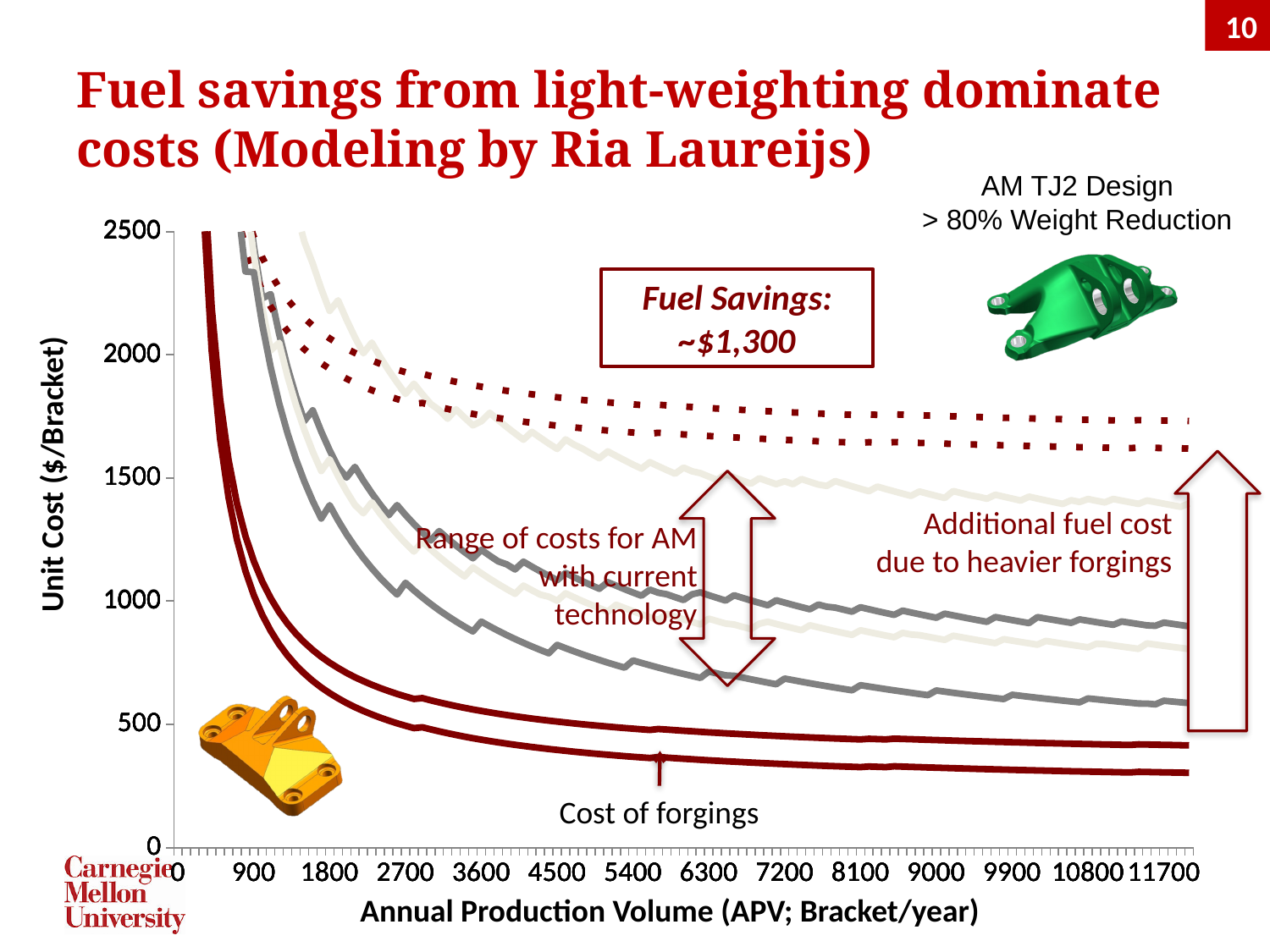
Which is higher at an annual production volume of 9000: the dotted lines or the solid dark red cost of forgings lines? the dotted lines What kind of chart is shown on the slide? line chart Do the unit cost curves rise or fall as annual production volume increases? fall At an annual production volume of 11700, are the dotted lines (forgings with additional fuel cost) greater or less than 1500 $/Bracket? greater What fuel savings amount is stated in the box on the chart? ~$1,300 At an annual production volume of 900, is the cost of forgings (solid dark red lines) greater or less than 500 $/Bracket? greater What is the maximum value shown on the y axis? 2500 What is the label of the y axis? Unit Cost ($/Bracket) What is the label of the x axis? Annual Production Volume (APV; Bracket/year) At an annual production volume of 11700, are the gray AM cost lines greater or less than 1000 $/Bracket? less